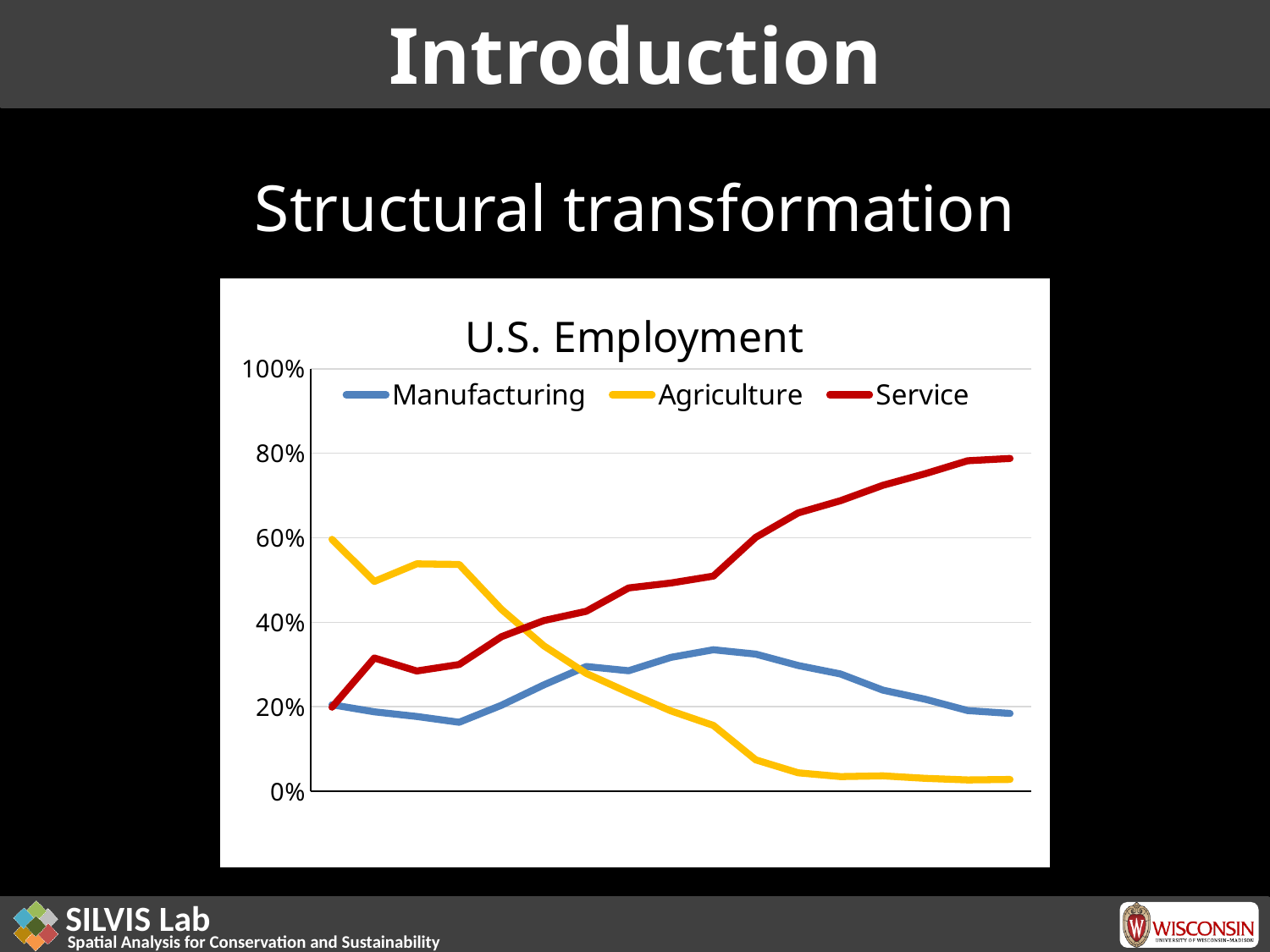
What is the title of the chart on the slide? U.S. Employment Which series has the highest value at the left end of the chart? Agriculture Which series in the U.S. Employment chart is drawn in red? Service Which series has the highest value at the right end of the chart? Service Is the final value of the Agriculture line greater or less than 20%? less Does the Agriculture line rise or fall from left to right? fall Does the Service line rise or fall from left to right? rise Is the final value of the Service line greater or less than 60%? greater How many series does the legend of the U.S. Employment chart list? 3 What kind of chart is shown on the slide? line chart Which series has the lowest value at the right end of the chart? Agriculture Is the highest point of the Manufacturing line greater or less than 40%? less